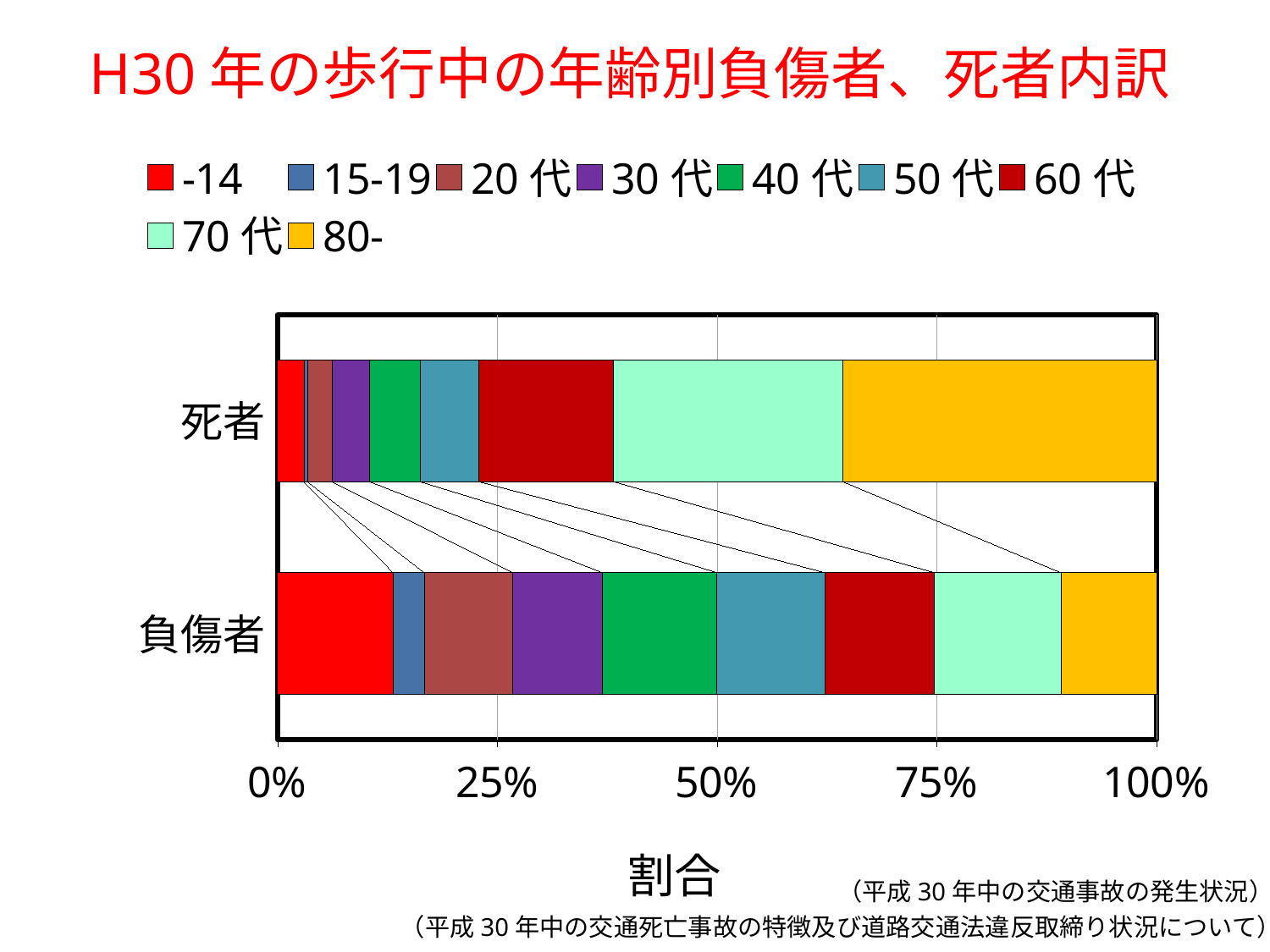
What is the title of the chart on the slide? H30年の歩行中の年齢別負傷者、死者内訳 Which bar has the larger share for 80-, 死者 or 負傷者? 死者 How many categories (bars) does the chart show? 2 Which age group has the largest share in the 死者 bar? 80- What is the label of the horizontal axis? 割合 Which bar has the larger share for -14, 死者 or 負傷者? 負傷者 What kind of chart is shown on the slide? Stacked bar chart Is the share of 80- in the 死者 bar greater or less than 25%? greater Is the share of -14 in the 負傷者 bar greater or less than 25%? less Is the combined share of 70代 and 80- in the 死者 bar greater or less than 50%? greater How many series does the legend list? 9